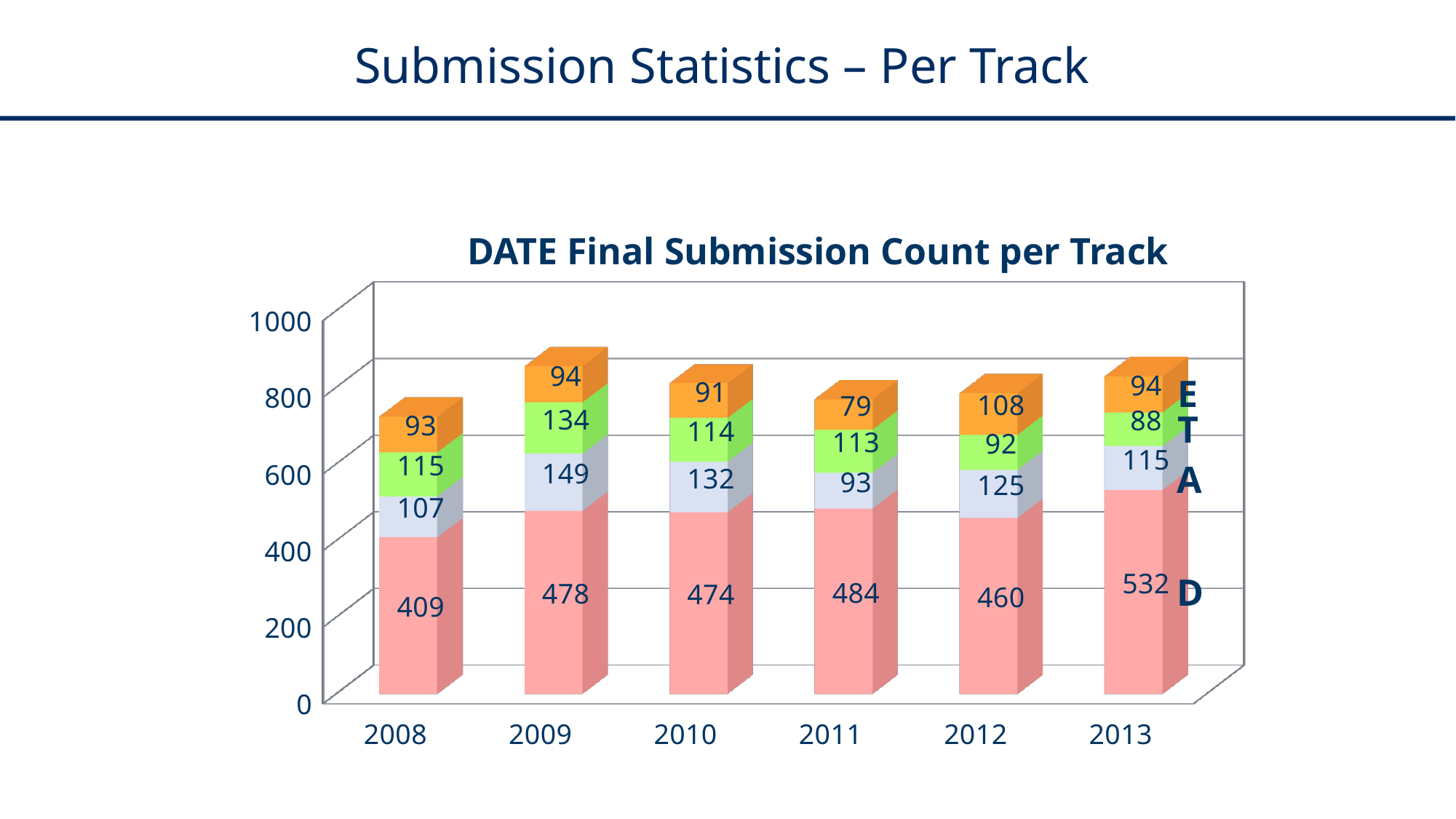
Which year has the highest value for track D? 2013 Which year has the lowest value for track E? 2011 What is the total of the stacked bar for 2009? 855 What is the total of the stacked bar for 2008? 724 What is the difference between the track D values for 2013 and 2008? 123 Which is larger, the track T value in 2009 or in 2013? 2009 How many tracks (series) are stacked in each bar? 4 What is the value for track A in 2009? 149 What is the value for track D in 2013? 532 What is the value for track E in 2012? 108 How many years are shown on the x axis? 6 What type of chart is shown? Stacked bar chart